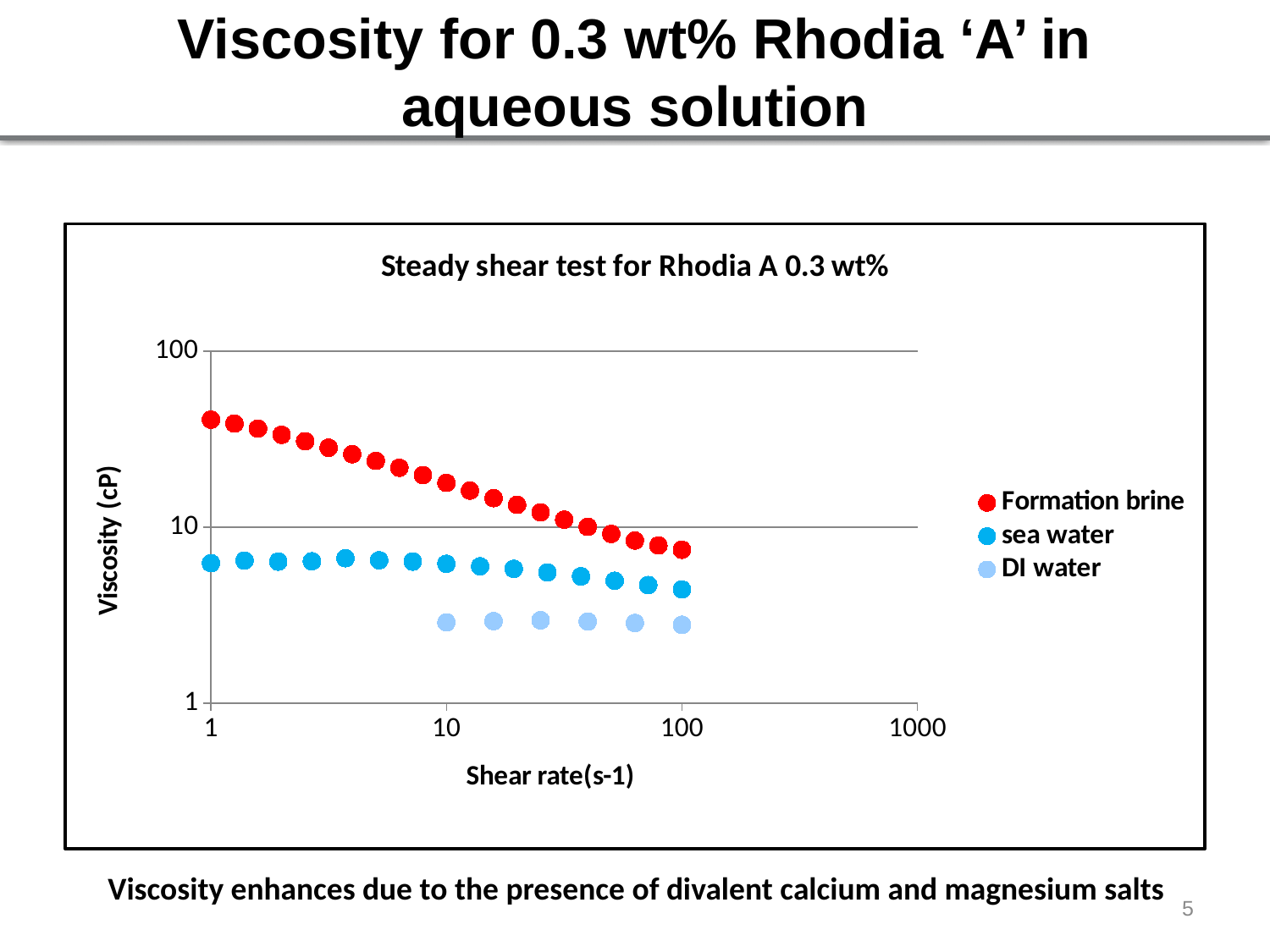
Is the viscosity for Formation brine at a shear rate of 1 greater or less than 10? greater What is the title of the chart? Steady shear test for Rhodia A 0.3 wt% Does the viscosity for Formation brine rise or fall as shear rate increases? fall What is the label of the y axis? Viscosity (cP) Which series has the highest viscosity values across the shear rate range? Formation brine Which series has the lowest viscosity values? DI water How many data points are plotted for the DI water series? 6 What kind of chart is shown on the slide? scatter chart How many series does the legend list? 3 Is the viscosity for sea water at a shear rate of 1 greater or less than 10? less Is the viscosity for Formation brine at a shear rate of 100 greater or less than 10? less At a shear rate of 10, which series has the larger viscosity, sea water or DI water? sea water